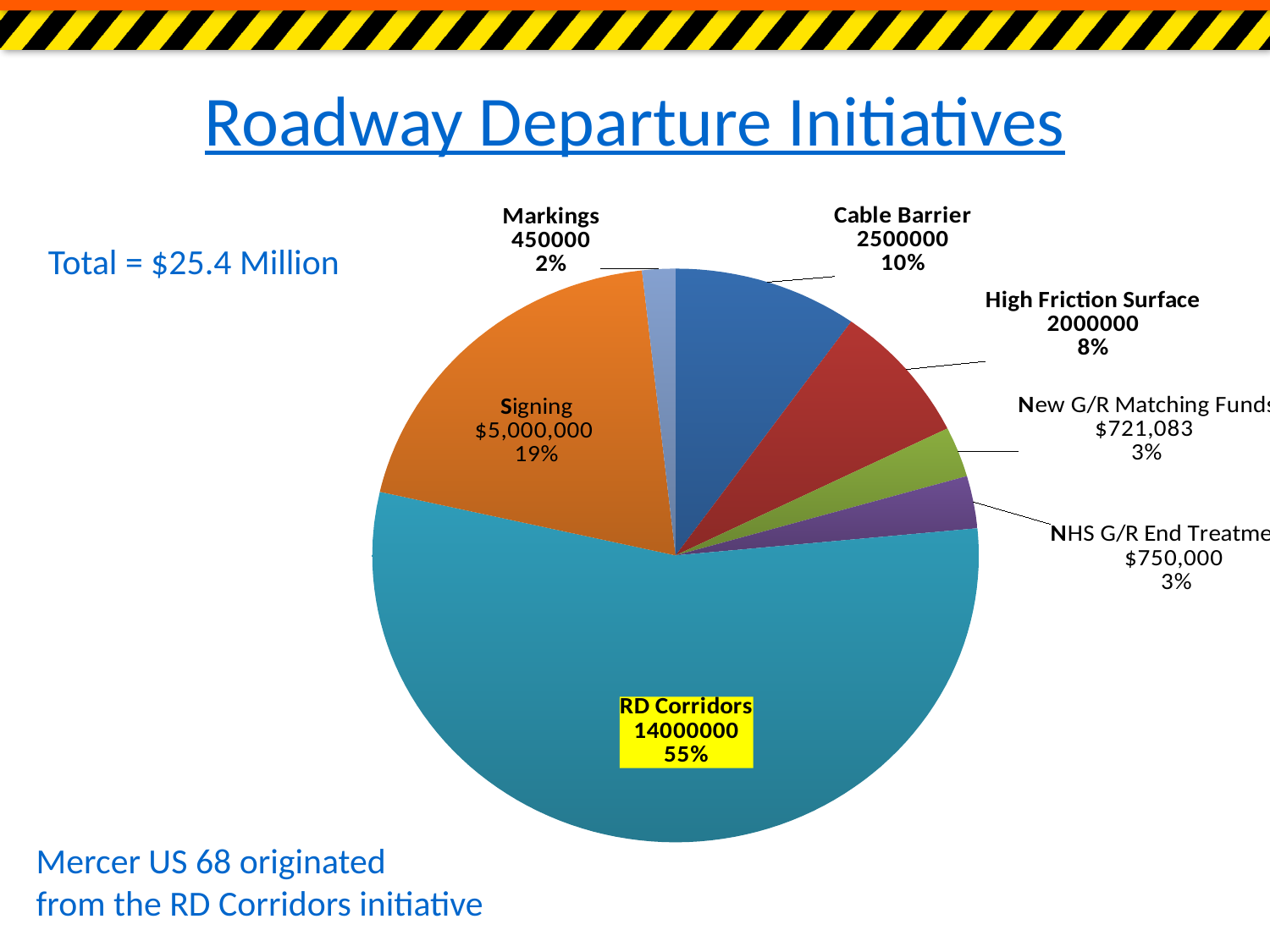
What value is shown for Cable Barrier? 2500000 Which is larger, Cable Barrier or High Friction Surface? Cable Barrier What percentage share does the Markings slice represent? 2% Which category has the largest slice of the pie? RD Corridors What total amount is stated next to the pie chart? $25.4 Million Which category has the smallest slice of the pie? Markings What percentage share does the Signing slice represent? 19% What value is shown for the RD Corridors slice? 14000000 What type of chart is shown on the slide? pie chart What value is shown for New G/R Matching Funds? $721,083 How many slices does the pie chart have? 7 What is the difference between the Cable Barrier value and the High Friction Surface value? 500000